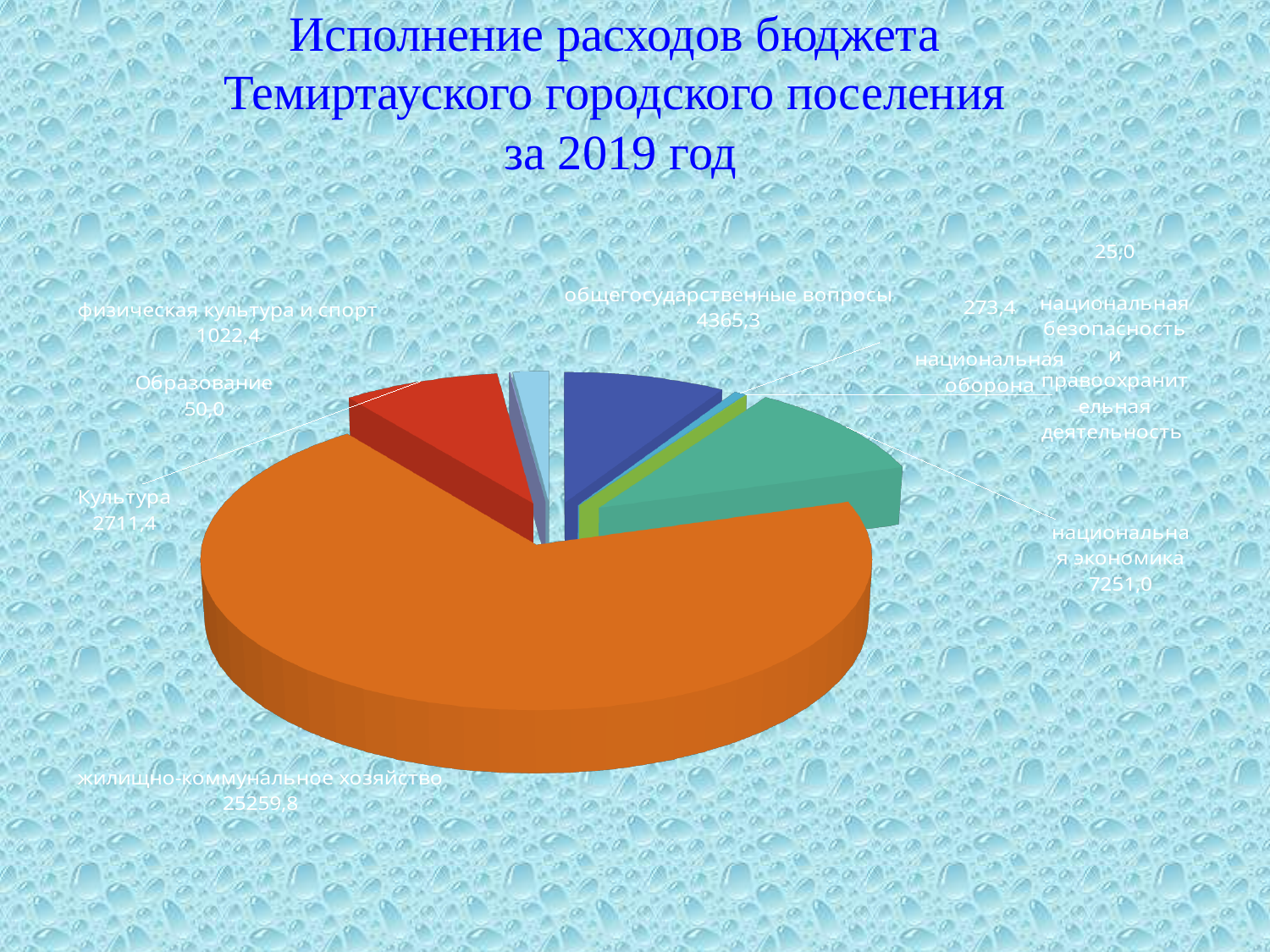
How many categories are shown in the pie chart? 8 What is the value for национальная экономика? 7251,0 Which is larger, Культура or физическая культура и спорт? Культура Which category has the largest slice of the pie? жилищно-коммунальное хозяйство What is the value for Культура? 2711,4 What is the title of the chart on the slide? Исполнение расходов бюджета Темиртауского городского поселения за 2019 год What is the difference between национальная экономика and общегосударственные вопросы? 2885,7 What is the value for жилищно-коммунальное хозяйство? 25259,8 What is the value for национальная оборона? 273,4 What kind of chart is shown on the slide? pie chart What is the value for общегосударственные вопросы? 4365,3 Which category has the smallest value? национальная безопасность и правоохранительная деятельность